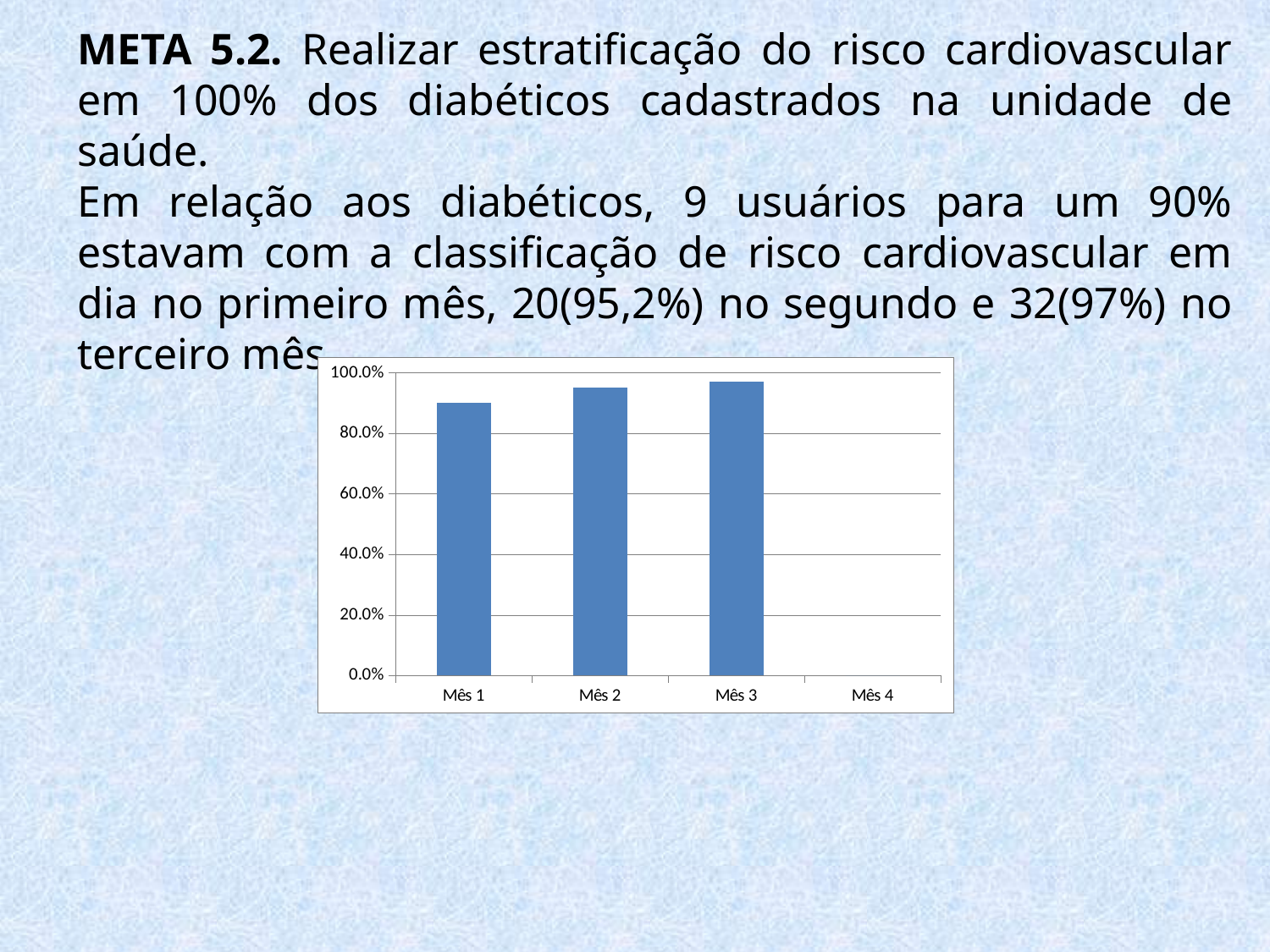
How many categories are shown on the x axis of the chart? 4 Is the value for Mês 1 greater or less than 100%? less Is the value for Mês 2 greater or less than 80%? greater Which is larger, the value for Mês 1 or the value for Mês 2? Mês 2 Do the values rise or fall from Mês 1 to Mês 3? rise What is the highest tick value shown on the y axis? 100.0% Is the value for Mês 3 greater or less than 100%? less Which is larger, the value for Mês 1 or the value for Mês 3? Mês 3 What kind of chart is shown on the slide? bar chart Which category on the x axis has no bar plotted? Mês 4